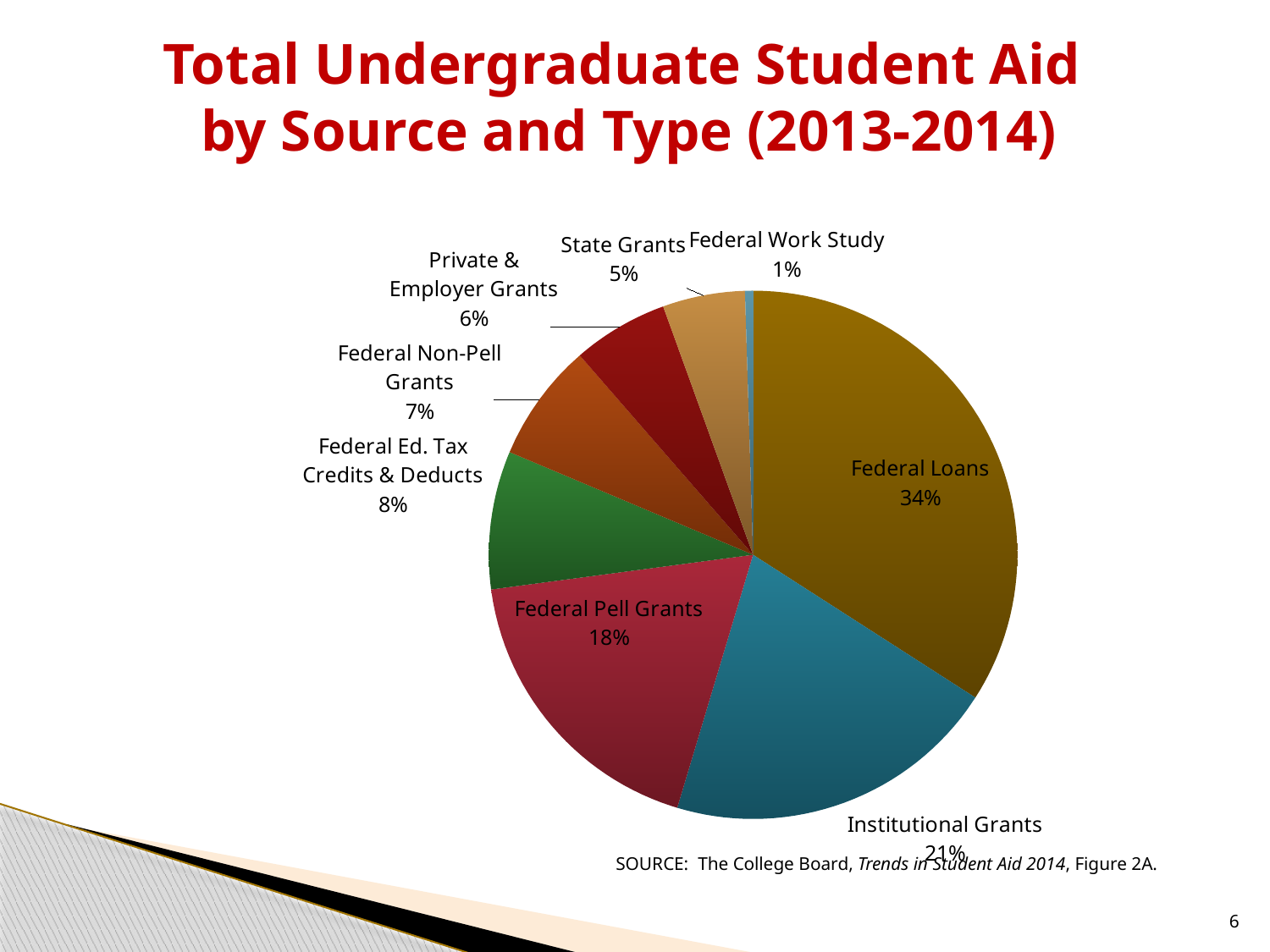
What share of total undergraduate student aid comes from Federal Pell Grants? 18% Which is larger, the share for Private & Employer Grants or the share for Federal Non-Pell Grants? Federal Non-Pell Grants What percentage is shown for Federal Ed. Tax Credits & Deducts? 8% What type of chart is shown on the slide? pie chart What is the title of the chart on the slide? Total Undergraduate Student Aid by Source and Type (2013-2014) What percentage is shown for Federal Non-Pell Grants? 7% What percentage is shown for State Grants? 5% Which source of aid has the smallest share of the pie? Federal Work Study Which source of aid has the largest share of the pie? Federal Loans What is the difference in percentage points between Federal Loans and Federal Pell Grants? 16 What share of total undergraduate student aid comes from Federal Loans? 34% How many slices does the pie chart have? 8